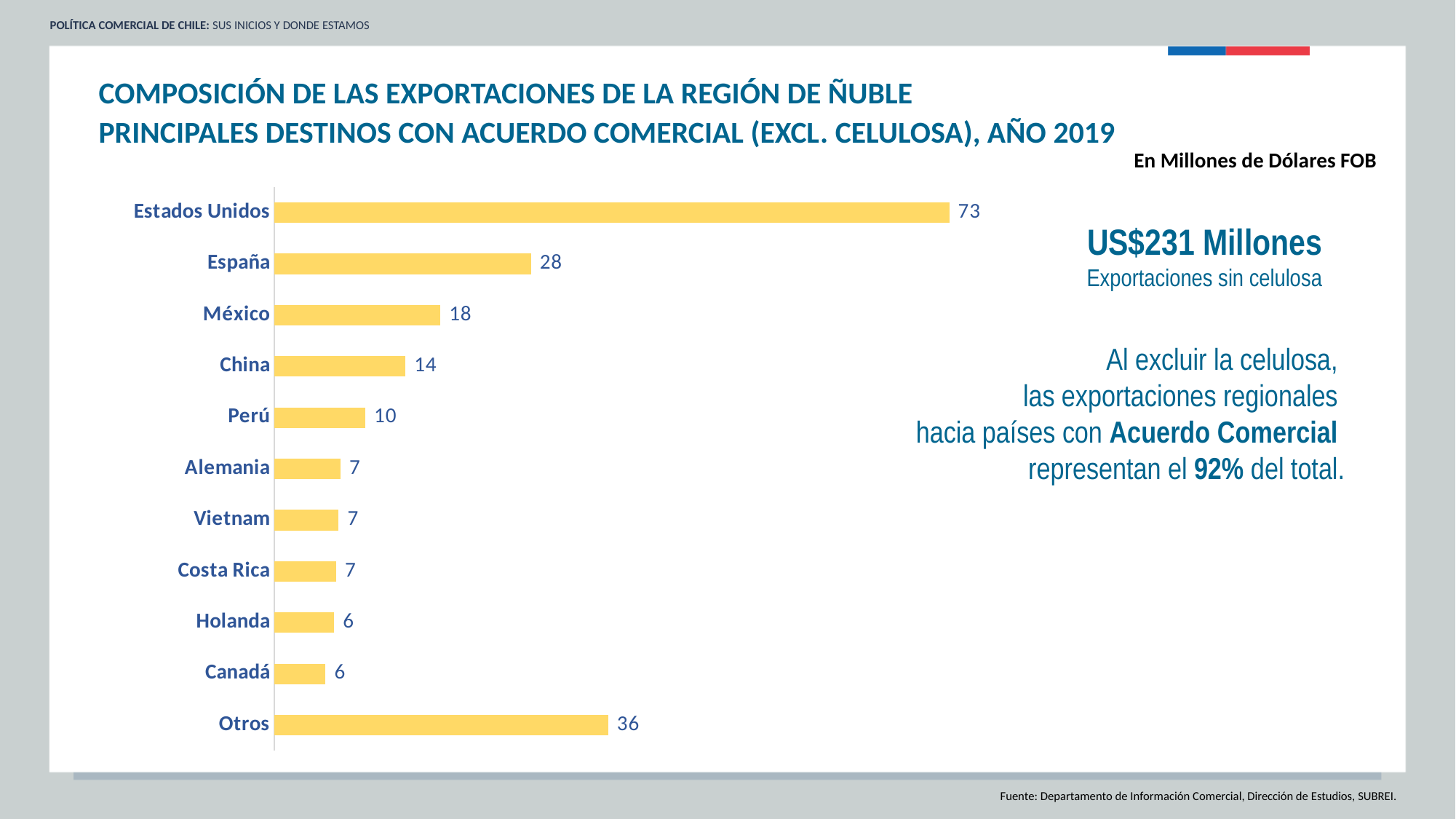
What is the value for Estados Unidos? 73 What is the value for Otros? 36 What is the value for Perú? 10 Which is larger, the value for Otros or the value for España? Otros What unit is stated for the values in the chart? En Millones de Dólares FOB What is the difference between the values for Estados Unidos and España? 45 What is the difference between the values for México and China? 4 Which is larger, the value for China or the value for Perú? China How many categories are shown in the chart? 11 What is the value for España? 28 Which category has the highest value? Estados Unidos What kind of chart is shown on the slide? Bar chart